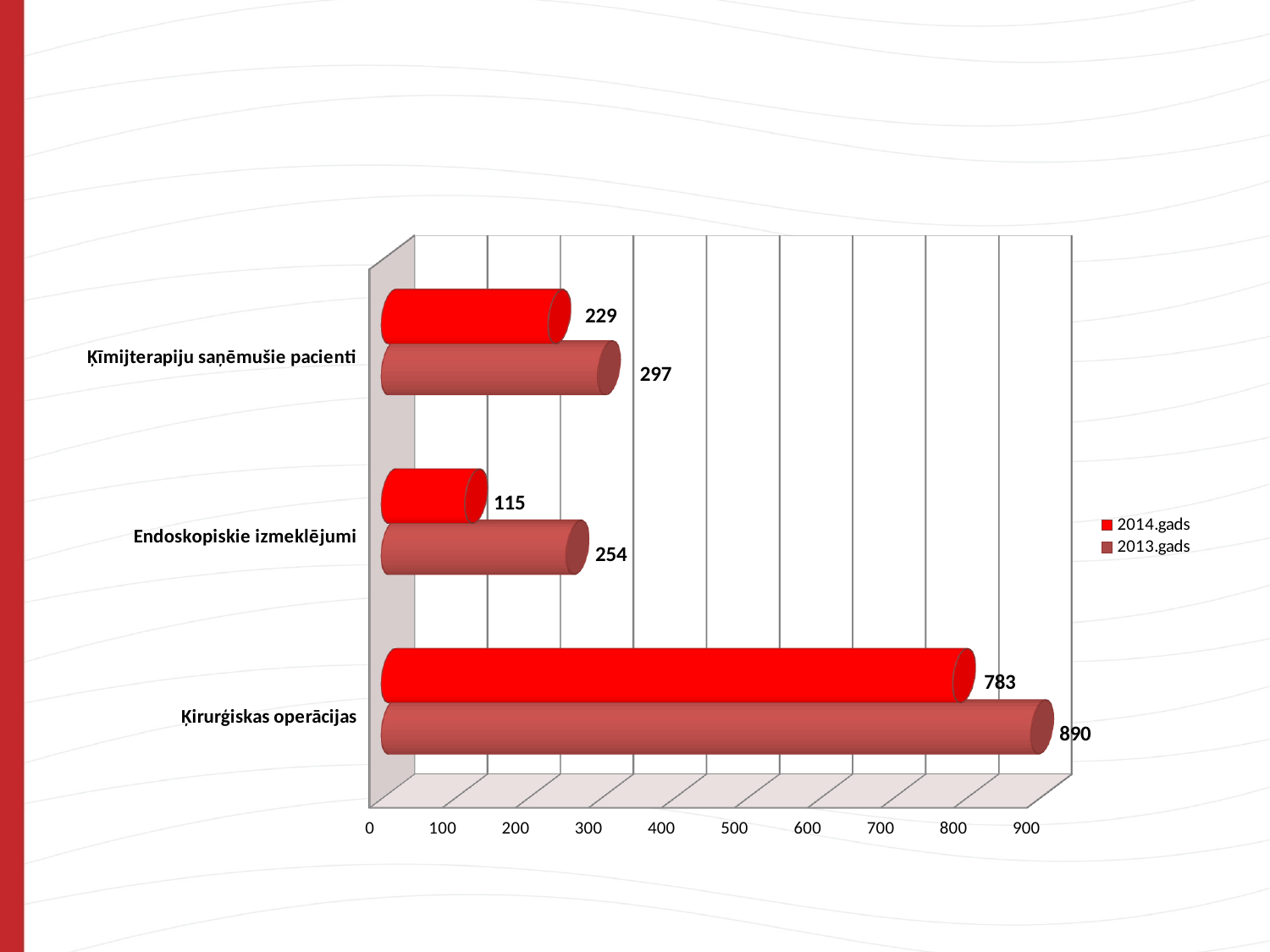
Which category has the highest value in the 2013.gads series? Ķirurģiskas operācijas What kind of chart is shown on the slide? Bar chart Which category has the lowest value in the 2014.gads series? Endoskopiskie izmeklējumi How many series does the legend list? 2 Which series is shown in bright red in the legend? 2014.gads What is the difference between the 2013.gads and 2014.gads values for Endoskopiskie izmeklējumi? 139 How many categories are shown on the chart? 3 What is the value for Endoskopiskie izmeklējumi in the 2013.gads series? 254 Which is larger for Ķīmijterapiju saņēmušie pacienti: the 2013.gads value or the 2014.gads value? 2013.gads What is the difference between the 2013.gads and 2014.gads values for Ķirurģiskas operācijas? 107 What is the value for Ķīmijterapiju saņēmušie pacienti in the 2014.gads series? 229 What is the value for Ķirurģiskas operācijas in the 2014.gads series? 783